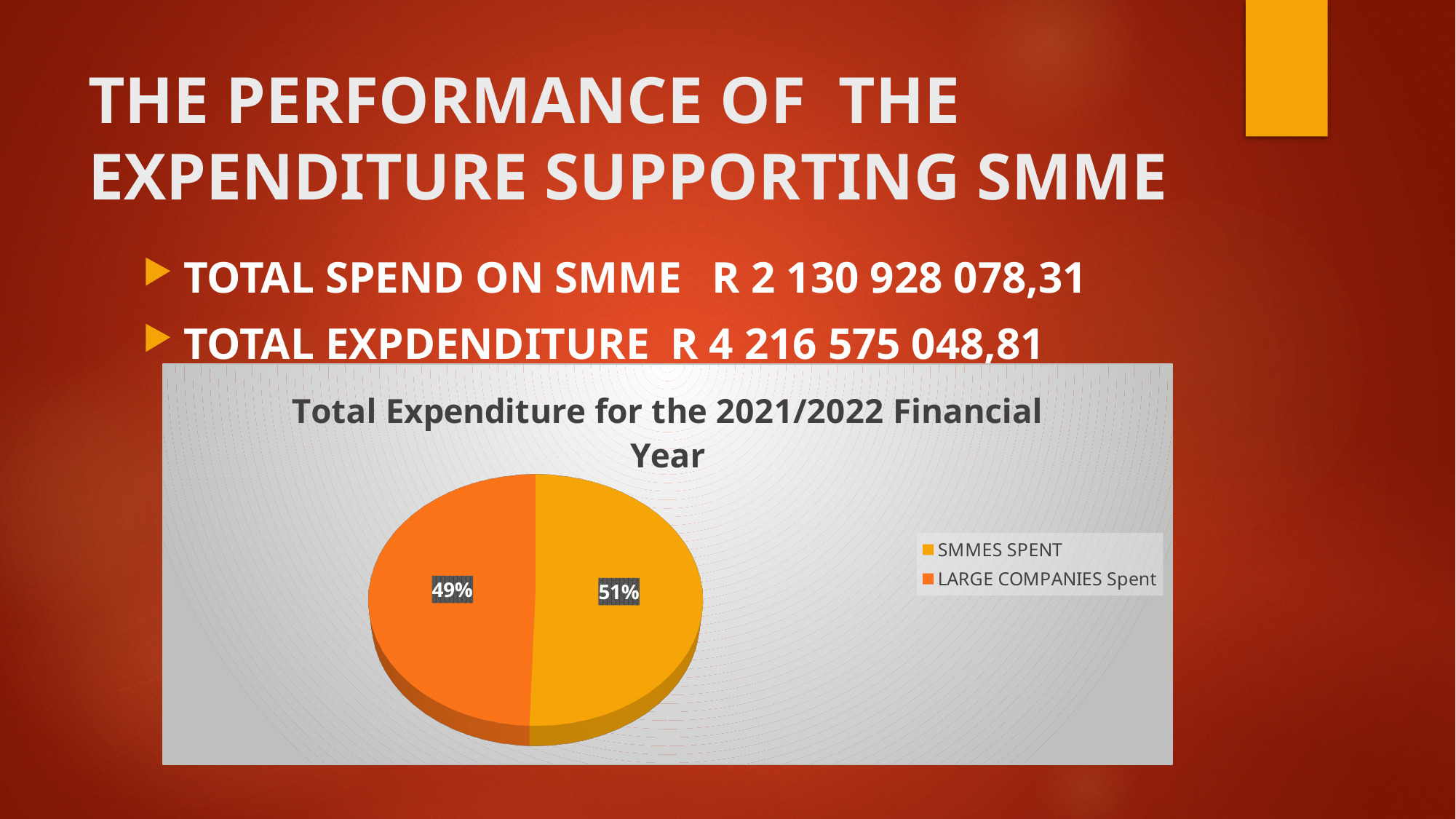
What share of the pie is labelled SMMES SPENT? 51% Which slice of the pie chart is the smallest? LARGE COMPANIES Spent Is the share for LARGE COMPANIES Spent greater or less than 50%? less By how many percentage points does the SMMES SPENT slice exceed the LARGE COMPANIES Spent slice? 2 percentage points What is the title of the pie chart? Total Expenditure for the 2021/2022 Financial Year What type of chart is shown on the slide? Pie chart What colour is the SMMES SPENT slice in the pie chart? Yellow Which is larger in the pie chart, SMMES SPENT or LARGE COMPANIES Spent? SMMES SPENT Which slice of the pie chart is the largest? SMMES SPENT How many entries does the legend of the pie chart list? 2 How many slices does the pie chart have? 2 What share of the pie is labelled LARGE COMPANIES Spent? 49%